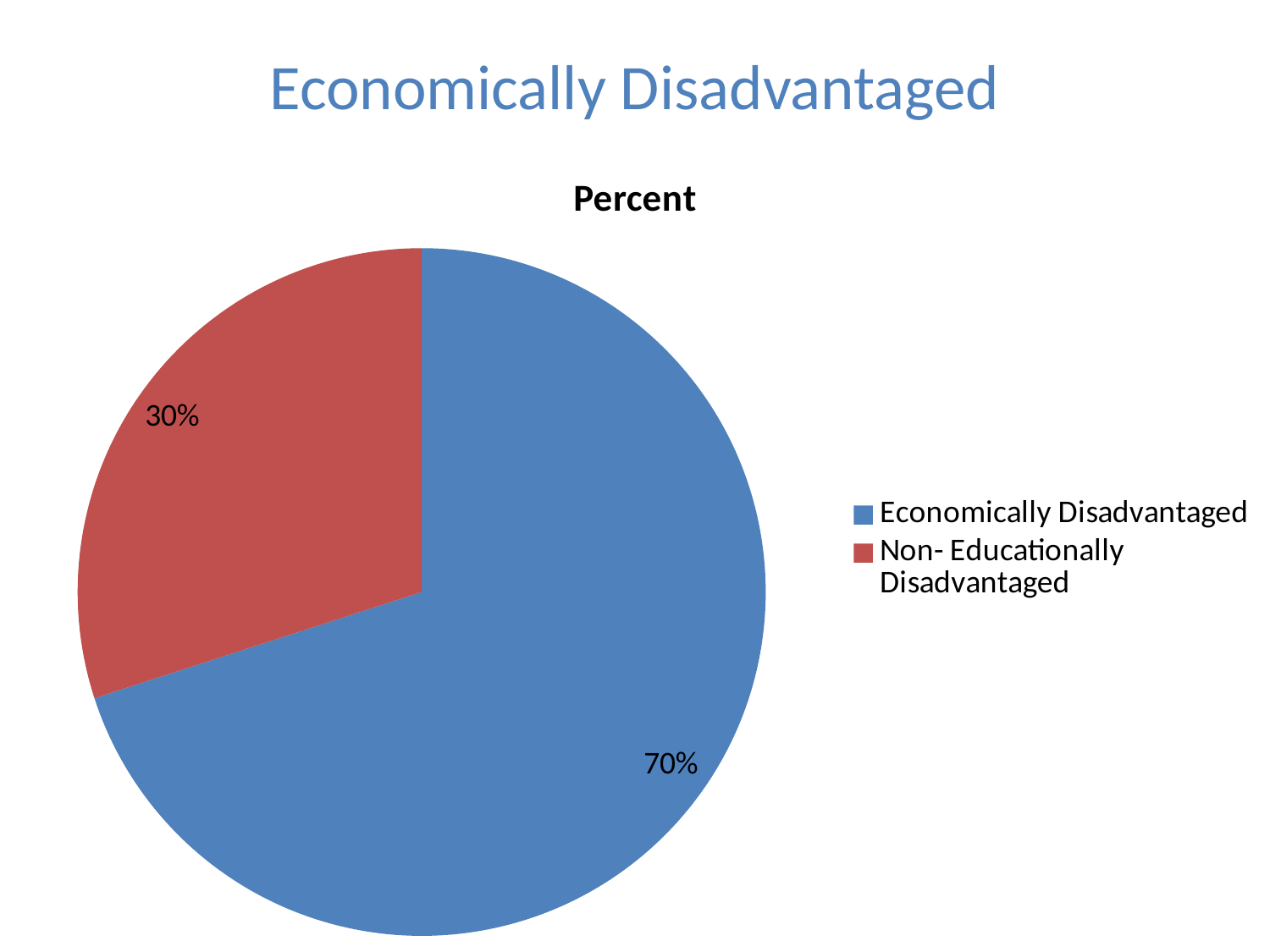
How many slices does the pie chart have? 2 How many entries does the legend list? 2 What percentage of the pie is Non- Educationally Disadvantaged? 30% What colour is the Non- Educationally Disadvantaged slice? Red What is the title of the chart? Percent Which is larger, the Economically Disadvantaged slice or the Non- Educationally Disadvantaged slice? Economically Disadvantaged What share of the pie does the Economically Disadvantaged slice take? 70% What is the difference in percentage points between the Economically Disadvantaged and Non- Educationally Disadvantaged slices? 40 Which slice of the pie is the largest? Economically Disadvantaged What kind of chart is shown on the slide? Pie chart What percentage of the pie is Economically Disadvantaged? 70% Which slice of the pie is the smallest? Non- Educationally Disadvantaged